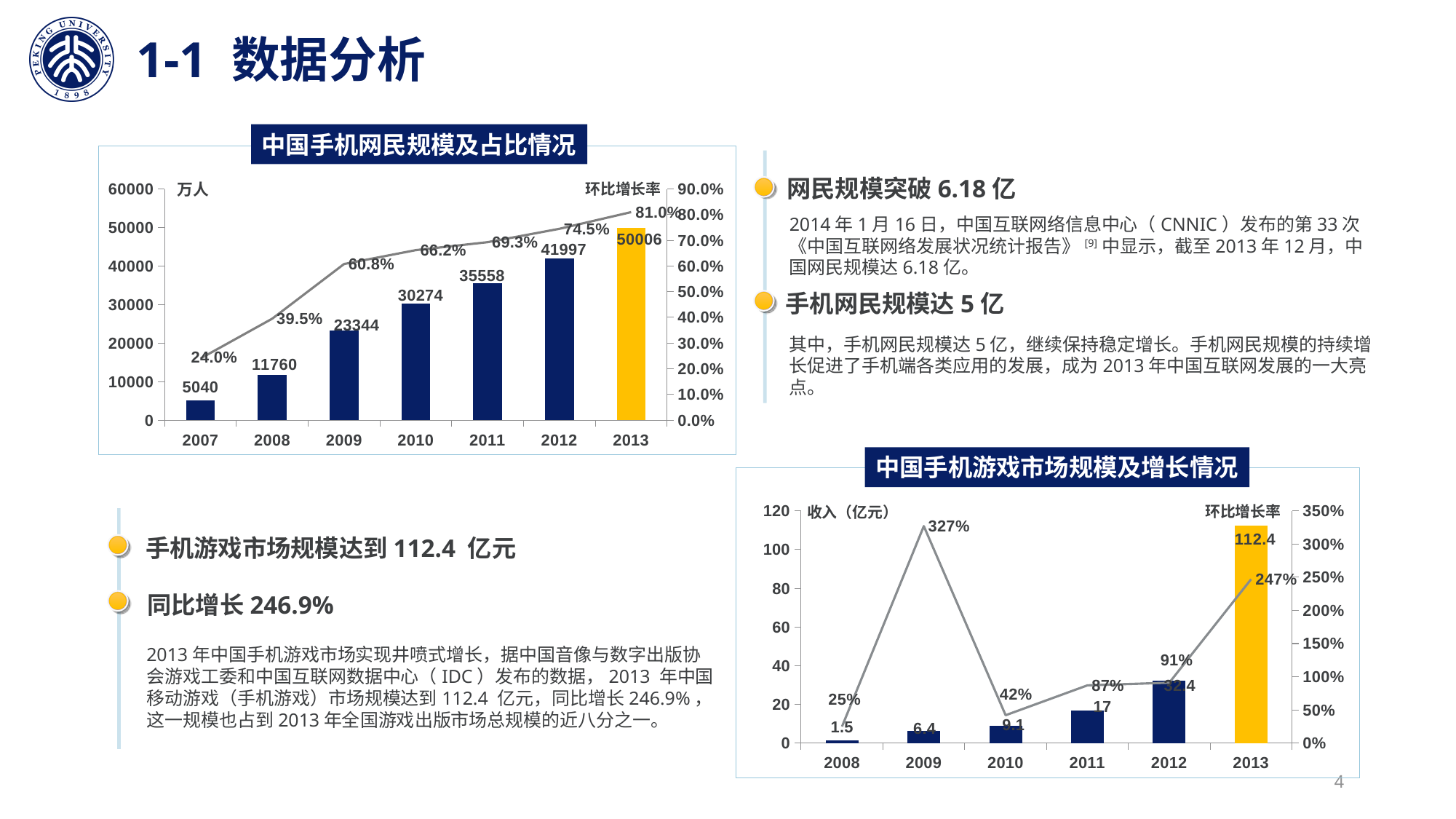
In the chart titled 中国手机网民规模及占比情况, what is the difference between the bar values for 2013 and 2012? 8009 In the chart titled 中国手机网民规模及占比情况, which year has the lowest bar value? 2007 In the chart titled 中国手机网民规模及占比情况, do the bar values rise or fall from 2007 to 2013? rise In the chart titled 中国手机游戏市场规模及增长情况, what is the 收入 value for 2013? 112.4 In the chart titled 中国手机游戏市场规模及增长情况, what is the 环比增长率 value for 2009? 327% In the chart titled 中国手机游戏市场规模及增长情况, which year has the highest 环比增长率? 2009 In the chart titled 中国手机网民规模及占比情况, what is the bar value for 2010? 30274 What kind of chart is the chart titled 中国手机游戏市场规模及增长情况? Combined bar and line chart In the chart titled 中国手机游戏市场规模及增长情况, what is the difference between the 收入 values for 2011 and 2009? 10.6 In the chart titled 中国手机网民规模及占比情况, what is the 环比增长率 value for 2009? 60.8% In the chart titled 中国手机网民规模及占比情况, how many years are shown on the x axis? 7 In the chart titled 中国手机游戏市场规模及增长情况, which is larger, the 收入 value for 2011 or for 2010? 2011